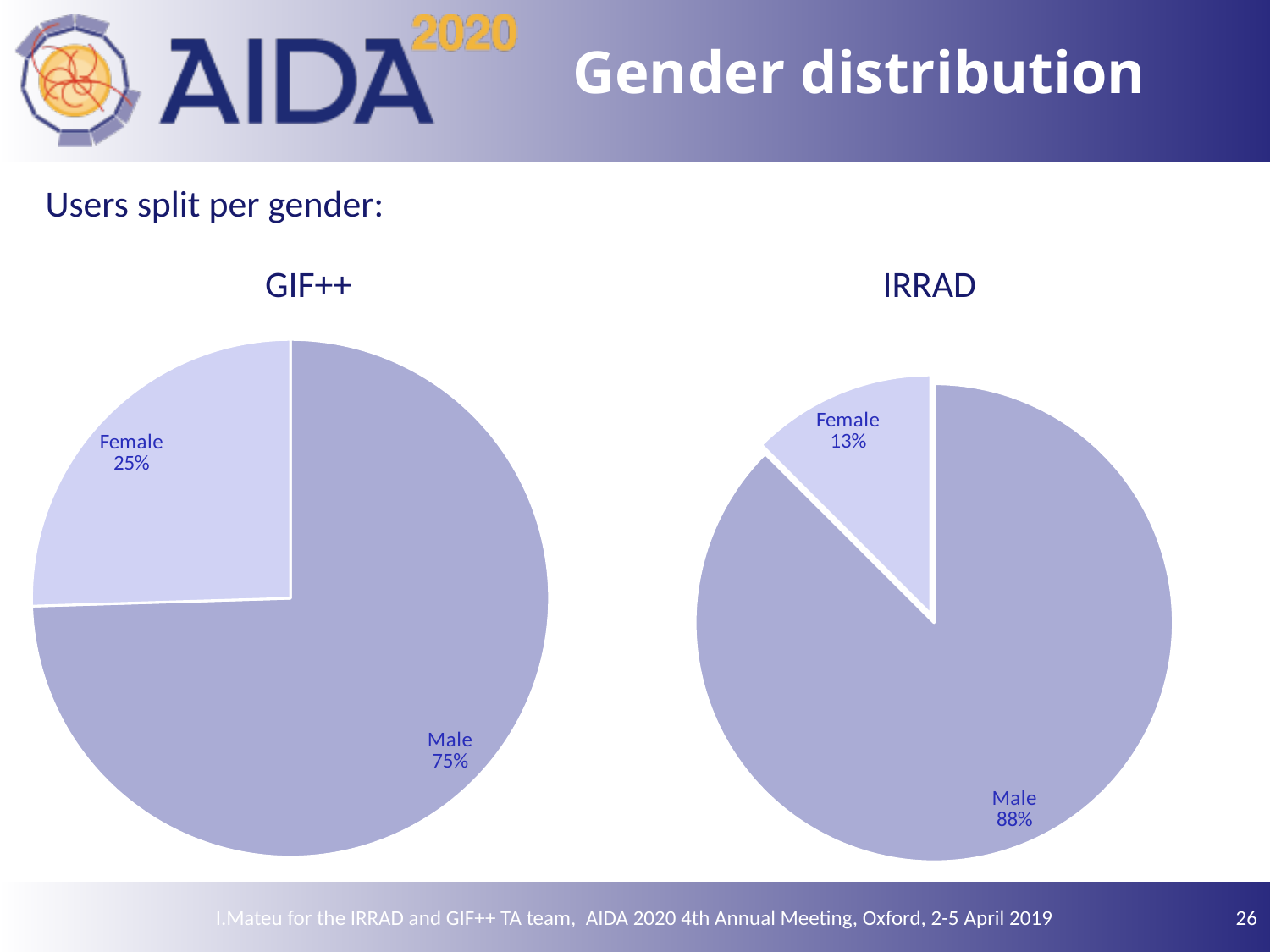
In the IRRAD chart, what share of users is Male? 88% In the IRRAD chart, what share of users is Female? 13% How many slices does the IRRAD chart have? 2 In the GIF++ chart, what is the difference between the Male and Female shares? 50% What is the title of the chart on the right of the slide? IRRAD In the GIF++ chart, which category has the largest slice? Male In the GIF++ chart, what share of users is Male? 75% In the IRRAD chart, what is the difference between the Male and Female shares? 75% Which chart has the larger Female share, GIF++ or IRRAD? GIF++ In the GIF++ chart, what share of users is Female? 25% What kind of chart is the GIF++ chart? Pie chart In the IRRAD chart, which category has the smallest slice? Female